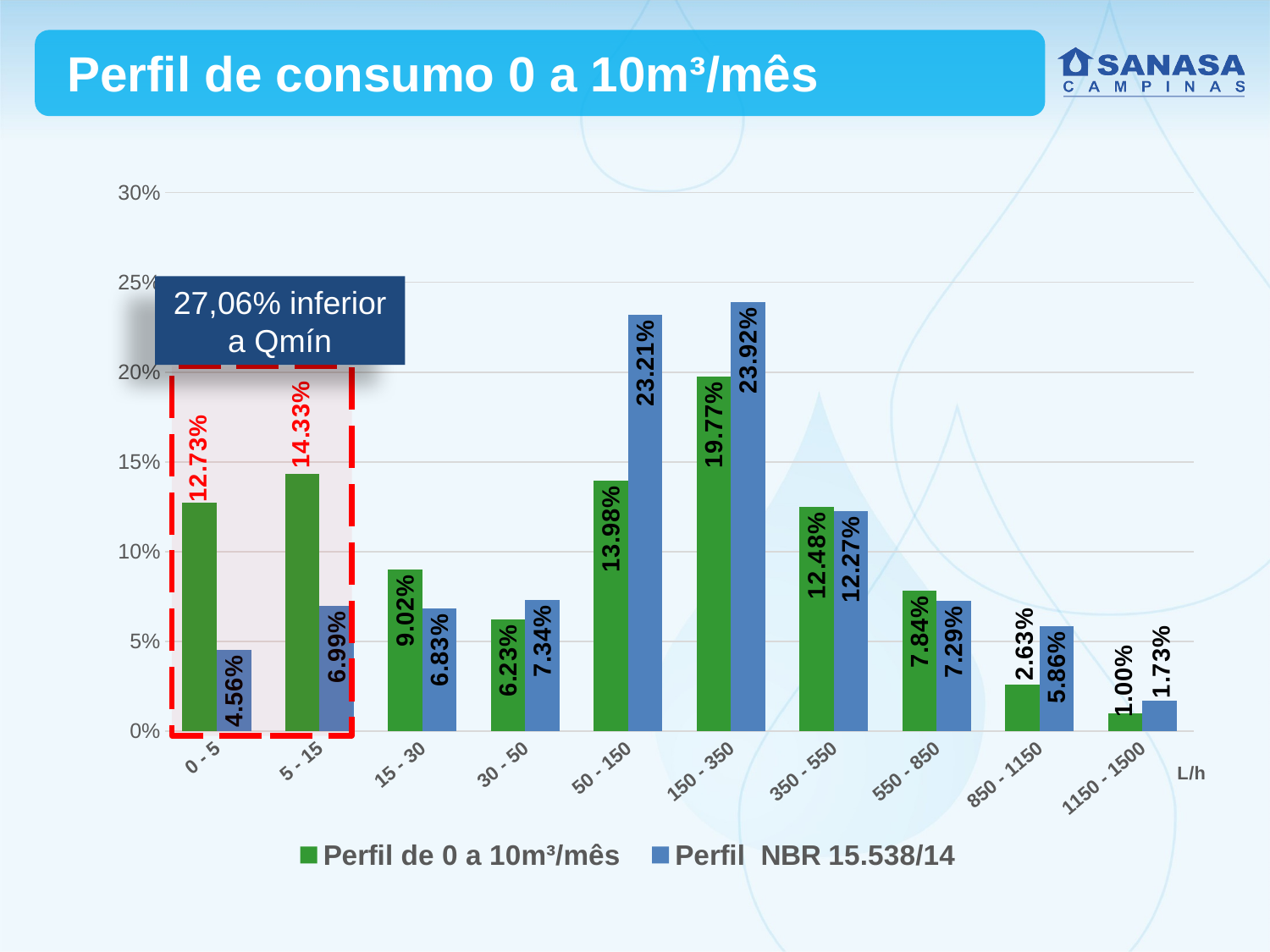
What is the value of the 'Perfil NBR 15.538/14' series for the '50 - 150' category? 23.21% How many categories are shown on the x axis? 10 What kind of chart is shown on the slide? Bar chart How many series does the legend list? 2 Is the 'Perfil NBR 15.538/14' value for '850 - 1150' greater or less than 5%? greater For the '30 - 50' category, which series has the larger value? Perfil NBR 15.538/14 Which category has the lowest value in the 'Perfil de 0 a 10m³/mês' series? 1150 - 1500 What is the title of the slide? Perfil de consumo 0 a 10m³/mês What is the value of the 'Perfil de 0 a 10m³/mês' series for the '150 - 350' category? 19.77% What is the difference between the 'Perfil de 0 a 10m³/mês' and 'Perfil NBR 15.538/14' values for the '5 - 15' category? 7.34% Which category has the highest value in the 'Perfil NBR 15.538/14' series? 150 - 350 What is the value of the 'Perfil de 0 a 10m³/mês' series for the '0 - 5' category? 12.73%